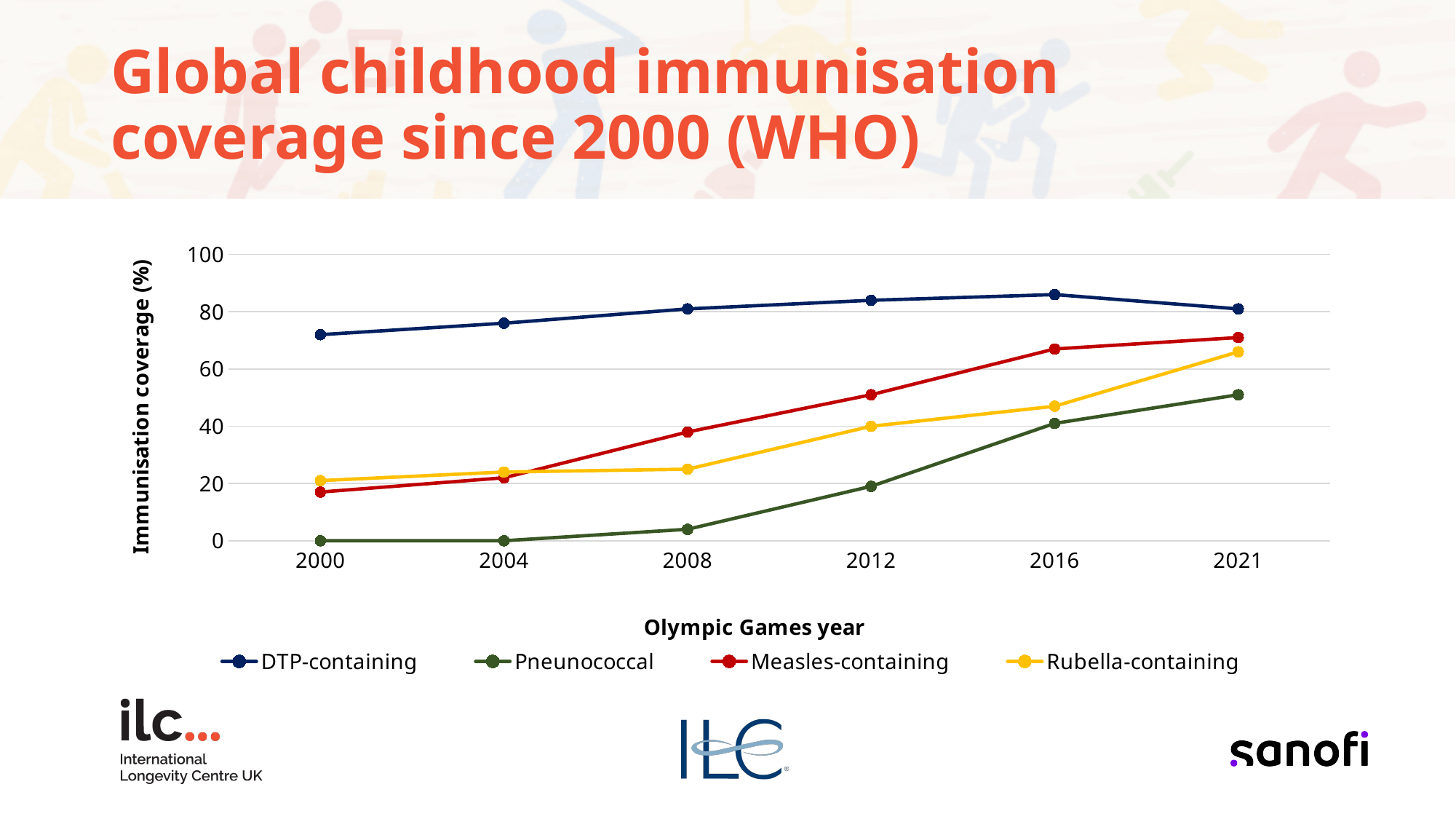
Is the value for Rubella-containing in 2008 greater or less than 40? less How many series does the legend list? 4 Does the Pneunococcal series rise or fall from 2000 to 2021? rise Which series has the lowest immunisation coverage in 2008? Pneunococcal What kind of chart is shown on the slide? line chart Is the value for DTP-containing in 2016 greater or less than 80? greater Is the value for Measles-containing in 2012 greater or less than 40? greater Which series has the highest immunisation coverage in 2021? DTP-containing Which is larger in 2016, the value for Measles-containing or the value for Rubella-containing? Measles-containing How many Olympic Games years are plotted along the x axis? 6 What is the title of the x axis? Olympic Games year